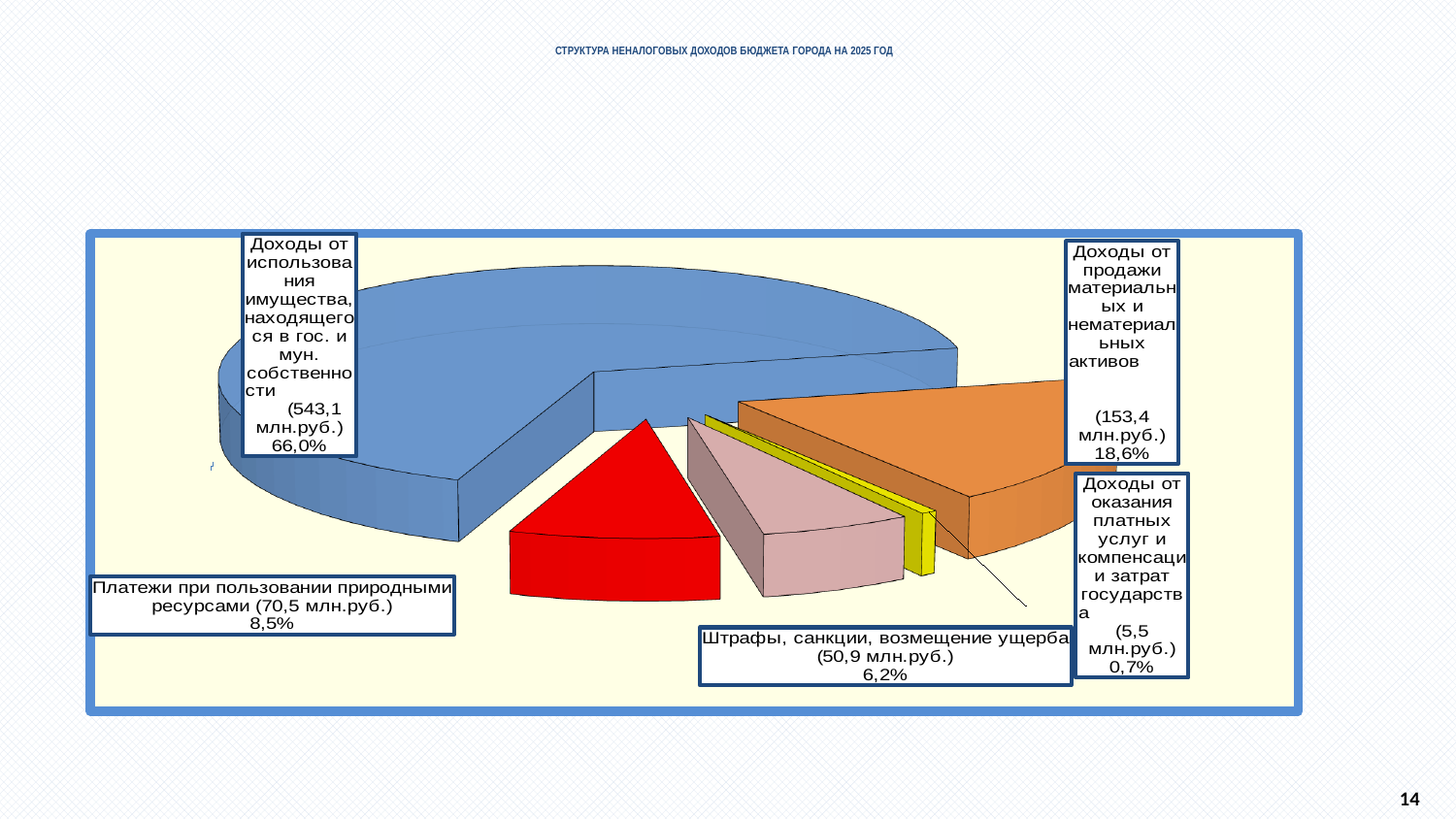
What kind of chart is shown on the slide? Pie chart What is the value shown for "Доходы от использования имущества, находящегося в гос. и мун. собственности"? 543,1 млн.руб. Which category has the largest share of the pie? Доходы от использования имущества, находящегося в гос. и мун. собственности What share of the pie does "Доходы от продажи материальных и нематериальных активов" represent? 18,6% What is the difference in percentage points between the share of "Доходы от продажи материальных и нематериальных активов" and the share of "Штрафы, санкции, возмещение ущерба"? 12,4 What is the title of the slide? СТРУКТУРА НЕНАЛОГОВЫХ ДОХОДОВ БЮДЖЕТА ГОРОДА НА 2025 ГОД How many slices does the pie chart have? 5 What is the value shown for "Доходы от оказания платных услуг и компенсации затрат государства"? 5,5 млн.руб. Which is larger: "Платежи при пользовании природными ресурсами" or "Штрафы, санкции, возмещение ущерба"? Платежи при пользовании природными ресурсами Which category has the smallest share of the pie? Доходы от оказания платных услуг и компенсации затрат государства What is the value shown for "Штрафы, санкции, возмещение ущерба"? 50,9 млн.руб. What share of the pie does "Платежи при пользовании природными ресурсами" represent? 8,5%